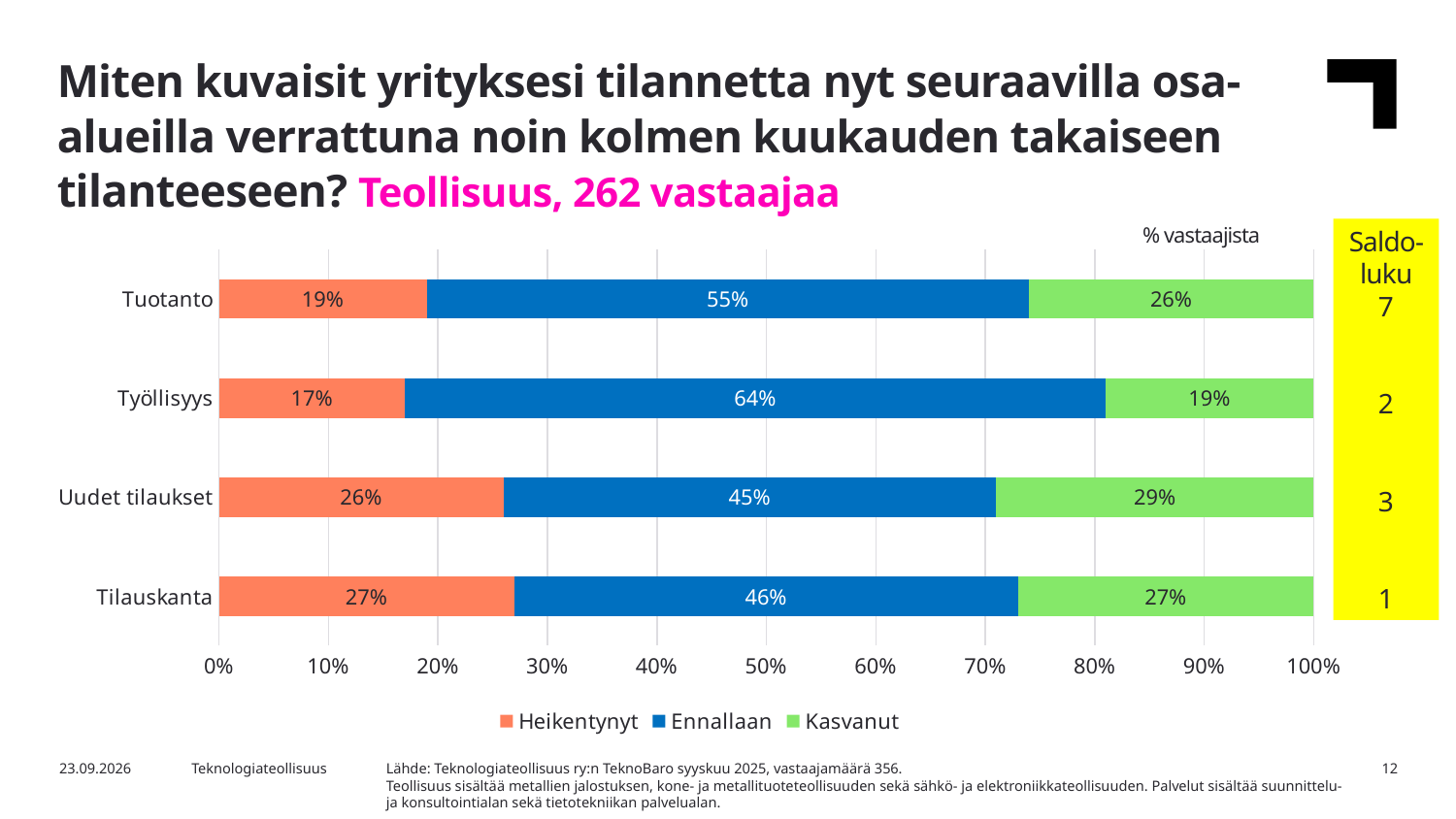
What kind of chart is shown on the slide? Stacked bar chart What is the "Heikentynyt" value for Tilauskanta? 27% What is the total of the three segments in the Tilauskanta bar? 100% Which is larger: the "Kasvanut" share for Tuotanto or for Työllisyys? Tuotanto What is the "Saldoluku" value shown for Tuotanto? 7 How many categories are shown on the chart? 4 How many series does the legend list? 3 What percentage of respondents answered "Ennallaan" for Tuotanto? 55% What is the difference between the "Ennallaan" values for Työllisyys and Uudet tilaukset? 19 percentage points What is the "Kasvanut" value for Uudet tilaukset? 29% Which category has the lowest "Heikentynyt" share? Työllisyys Which category has the highest "Ennallaan" share? Työllisyys